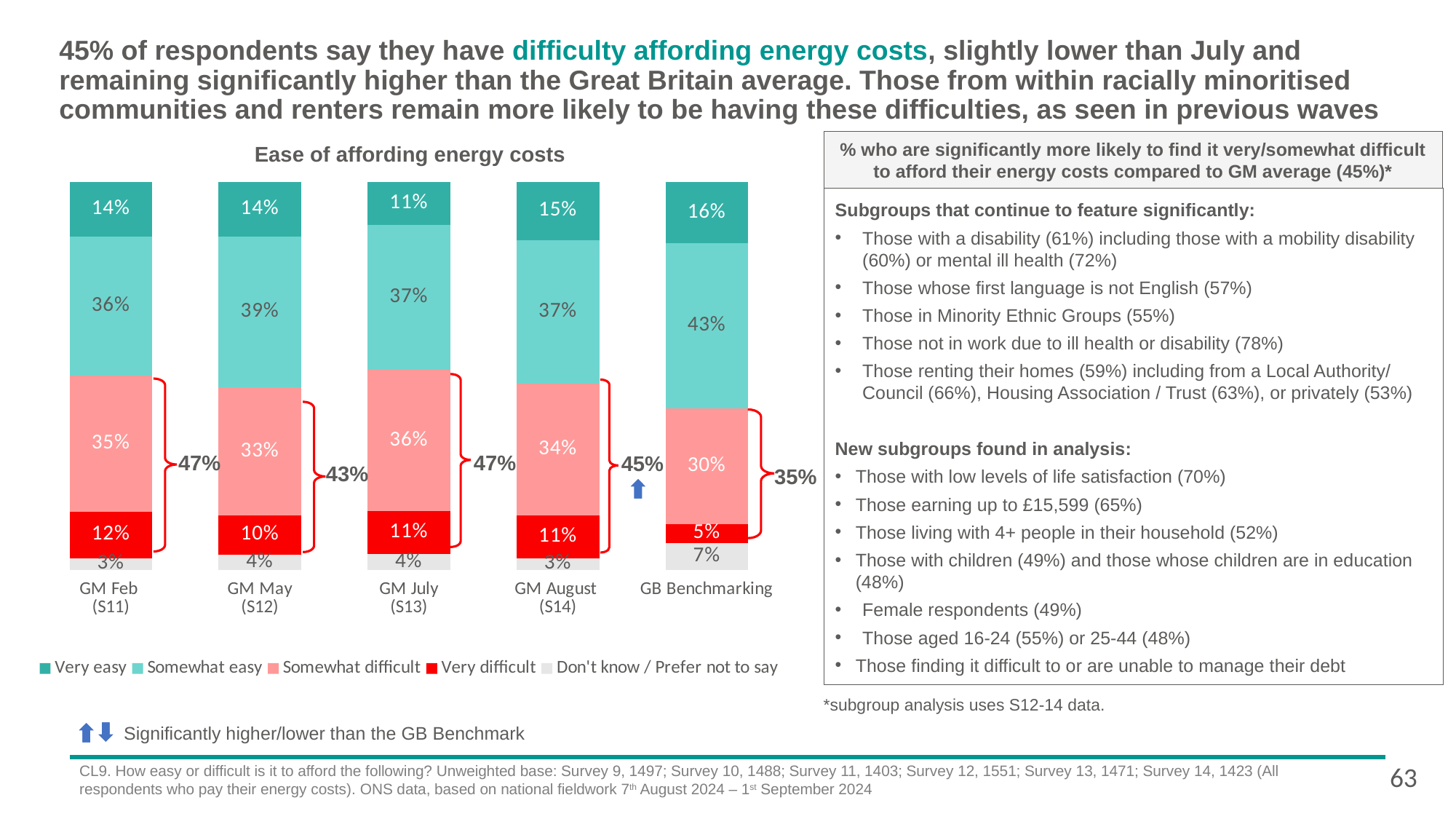
Which is larger: the 'Somewhat easy' value for GM May (S12) or for GM July (S13)? GM May (S12) Which bar has the lowest 'Very difficult' value? GB Benchmarking What is the 'Don't know / Prefer not to say' value for GB Benchmarking? 7% Which bar has the highest 'Somewhat difficult' value? GM July (S13) What is the 'Somewhat easy' value for GB Benchmarking? 43% What combined 'very/somewhat difficult' percentage is shown by the bracket for GM August (S14)? 45% What type of chart is 'Ease of affording energy costs'? Stacked bar chart How many bars (categories) are shown in the 'Ease of affording energy costs' chart? 5 What is the 'Very difficult' value for GM Feb (S11)? 12% How many series does the legend of the 'Ease of affording energy costs' chart list? 5 What is the difference between the 'Very difficult' values for GM Feb (S11) and GB Benchmarking? 7% What is the 'Very easy' value for GM August (S14)? 15%